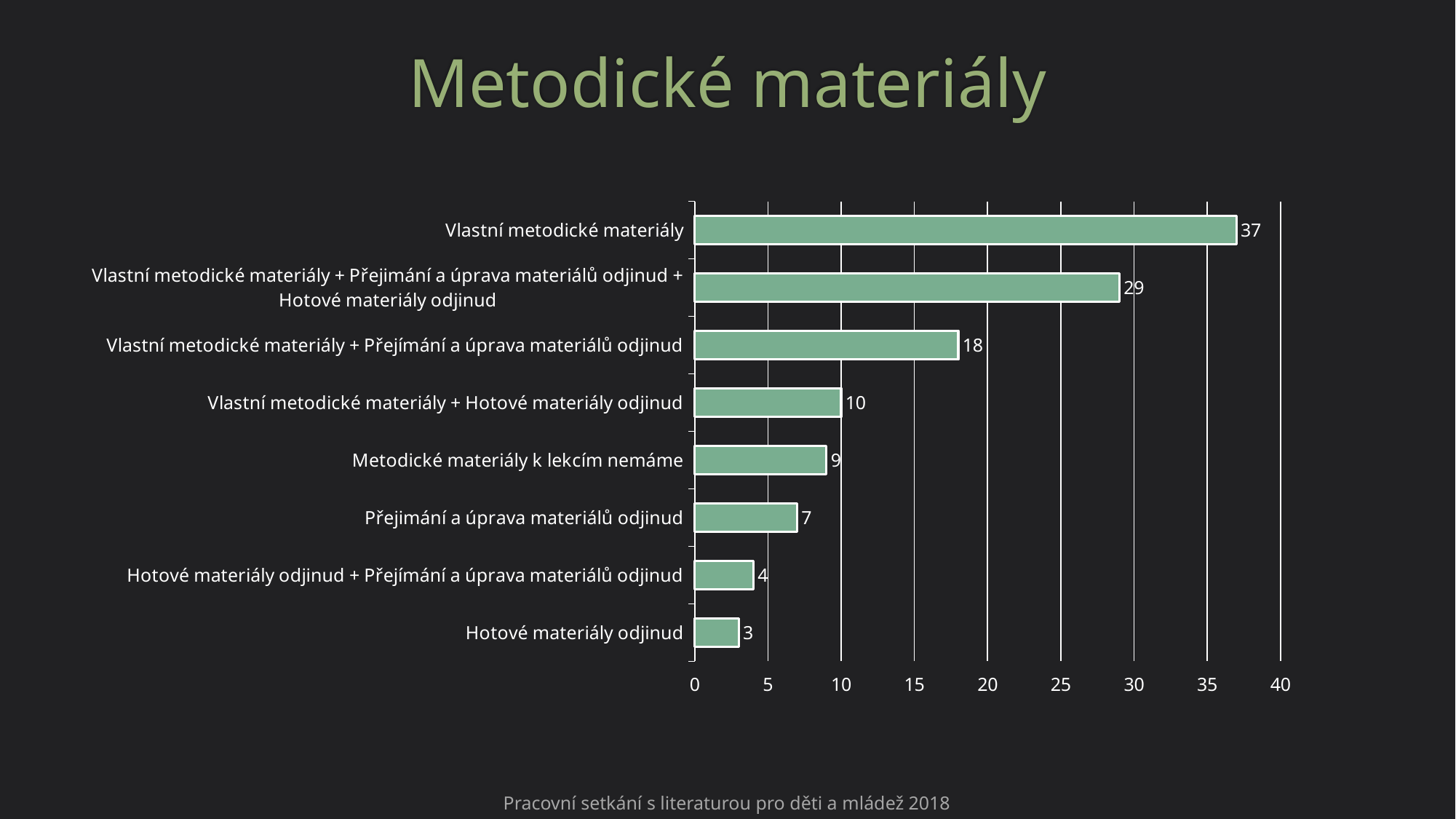
Which is larger: the value for "Přejimání a úprava materiálů odjinud" or the value for "Hotové materiály odjinud + Přejímání a úprava materiálů odjinud"? Přejimání a úprava materiálů odjinud What is the title of the slide? Metodické materiály How many categories are shown in the chart? 8 Is the value for "Vlastní metodické materiály + Přejimání a úprava materiálů odjinud + Hotové materiály odjinud" greater or less than 25? greater What is the value for "Vlastní metodické materiály + Přejímání a úprava materiálů odjinud"? 18 What is the value for "Metodické materiály k lekcím nemáme"? 9 What is the value for "Vlastní metodické materiály"? 37 Which category has the highest value? Vlastní metodické materiály Which category has the lowest value? Hotové materiály odjinud What is the difference between the values for "Vlastní metodické materiály" and "Vlastní metodické materiály + Přejimání a úprava materiálů odjinud + Hotové materiály odjinud"? 8 What kind of chart is shown on the slide? bar chart What is the value for "Hotové materiály odjinud"? 3